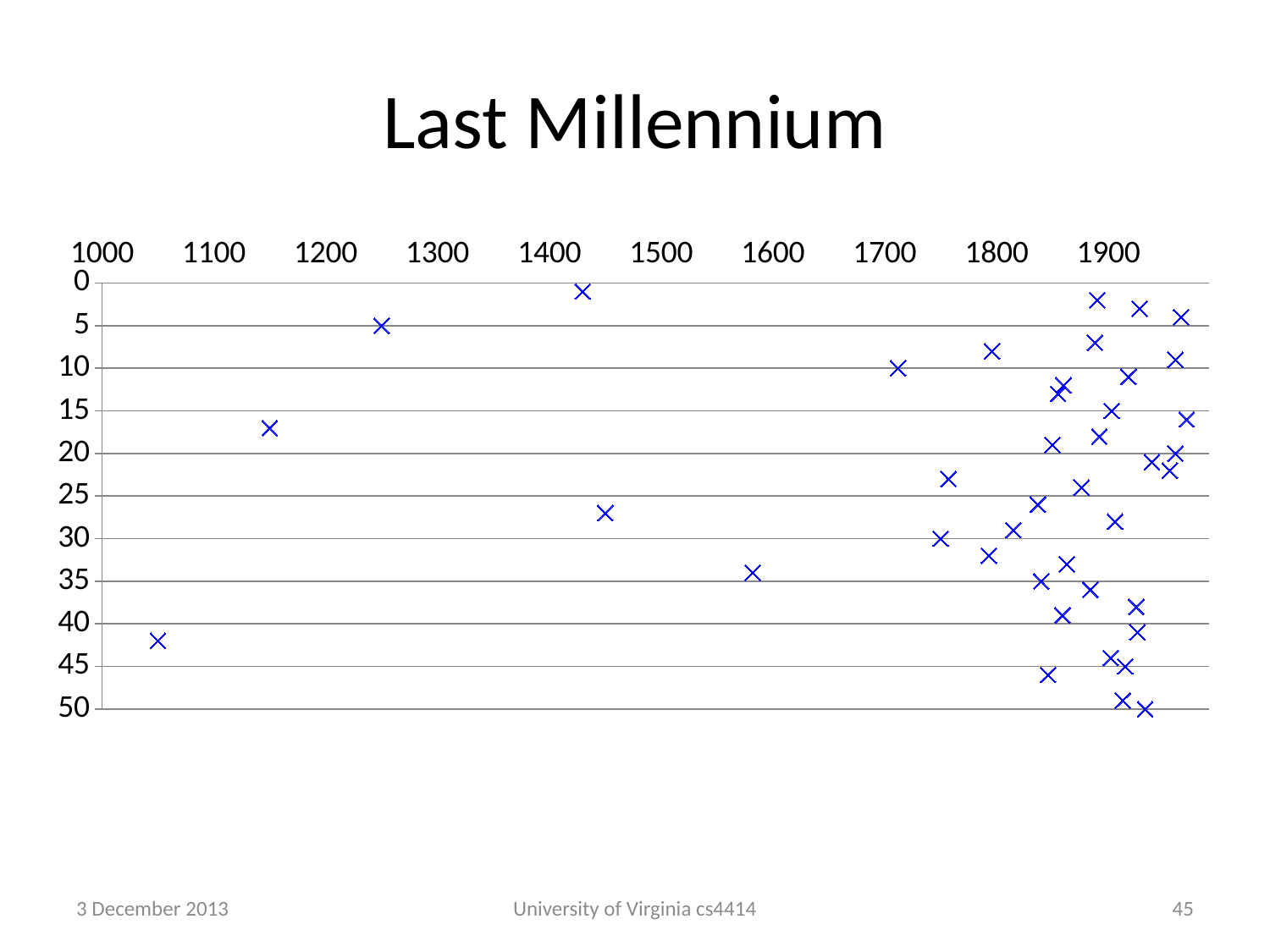
Is the y value of the point plotted near x = 1720 greater or less than 20? less Is the y value of the point plotted near x = 1580 greater or less than 20? greater Is the y value of the topmost point plotted between x = 1400 and x = 1450 greater or less than 5? less Which has the larger y value: the point plotted near x = 1050 or the point plotted near x = 1250? the point near x = 1050 What kind of chart is shown on the slide? scatter chart What is the leftmost year label on the horizontal axis? 1000 What is the largest value labelled on the vertical axis? 50 What is the title of the chart? Last Millennium